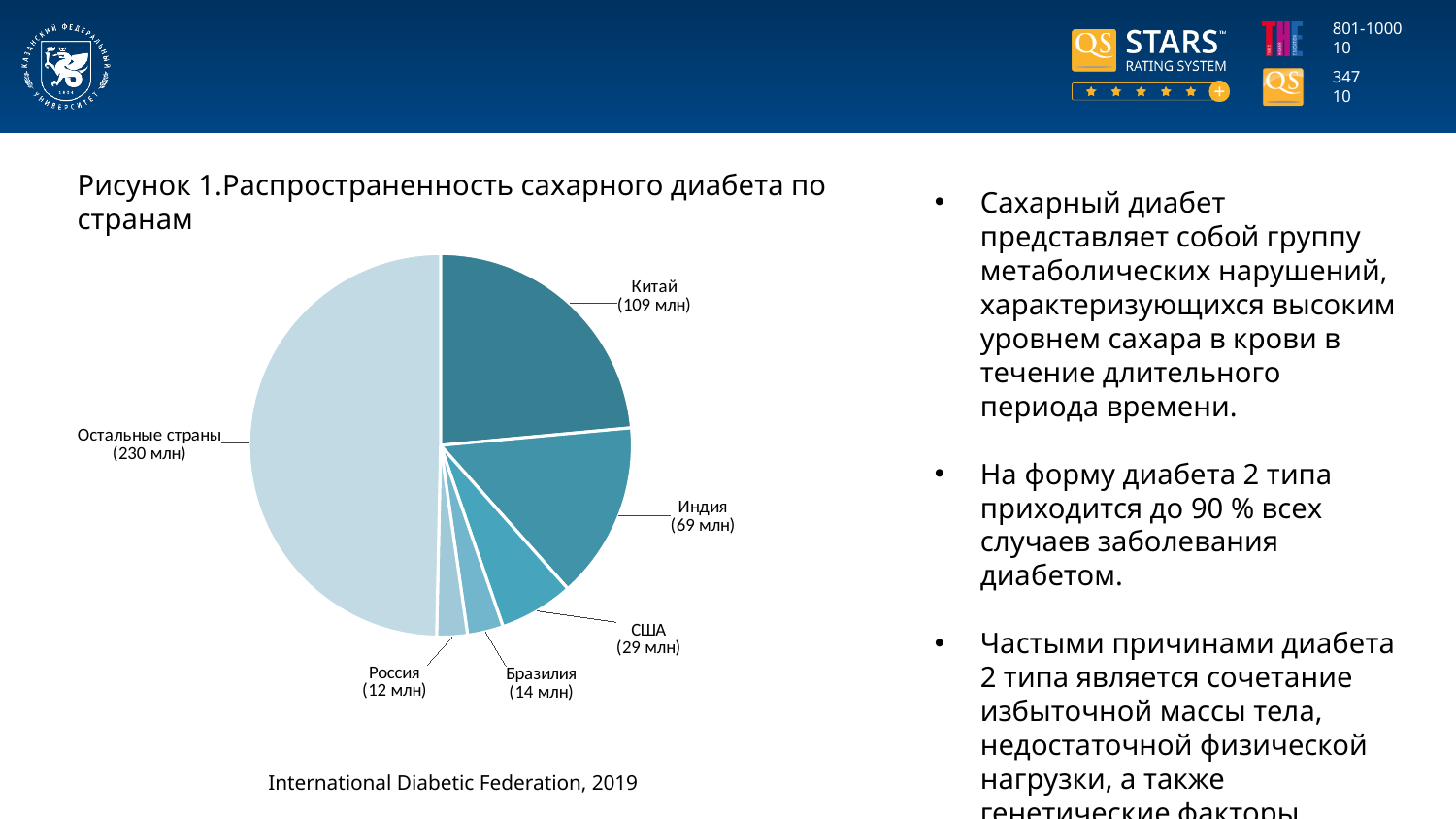
What value is shown for Китай in the pie chart? 109 млн Which slice of the pie chart has the smallest value? Россия What value is shown for США in the pie chart? 29 млн How many slices does the pie chart have? 6 What kind of chart is shown on the slide? Pie chart Which slice of the pie chart has the largest value? Остальные страны What value is shown for Индия in the pie chart? 69 млн What source is cited below the chart? International Diabetic Federation, 2019 What is the difference between the values for Китай and Индия? 40 млн What value is shown for Россия in the pie chart? 12 млн Which is larger, the value for США or the value for Бразилия? США What value is shown for Остальные страны in the pie chart? 230 млн